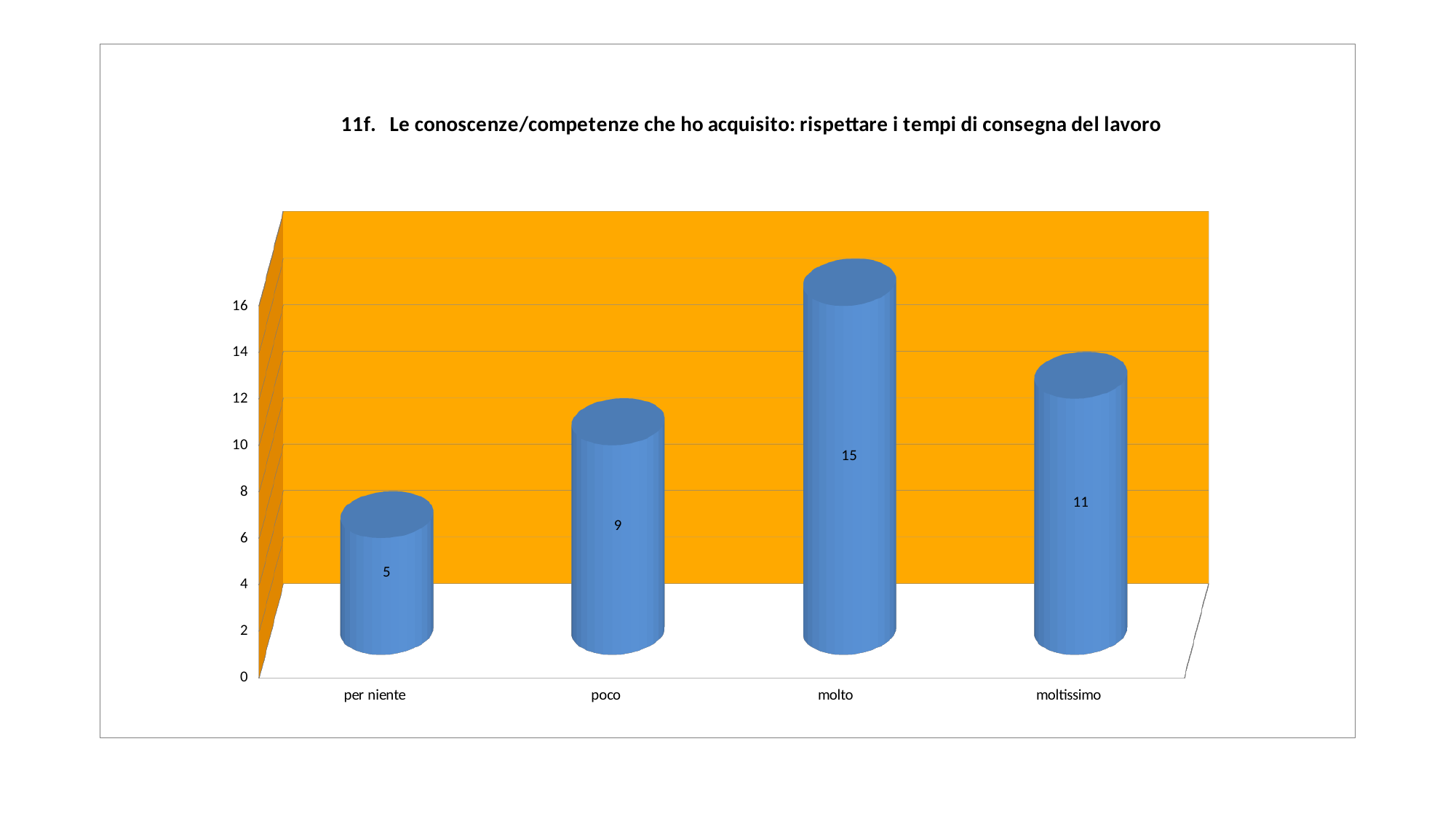
Which category has the lowest value? per niente How many categories are shown on the x axis? 4 What is the value for "per niente"? 5 What is the title of the chart? 11f. Le conoscenze/competenze che ho acquisito: rispettare i tempi di consegna del lavoro What is the value for "molto"? 15 Is the value for "molto" greater or less than 10? greater Which category has the highest value? molto What is the value for "poco"? 9 What is the difference between the values for "molto" and "moltissimo"? 4 What kind of chart is shown on the slide? bar chart Which is larger, the value for "poco" or the value for "moltissimo"? moltissimo What is the value for "moltissimo"? 11